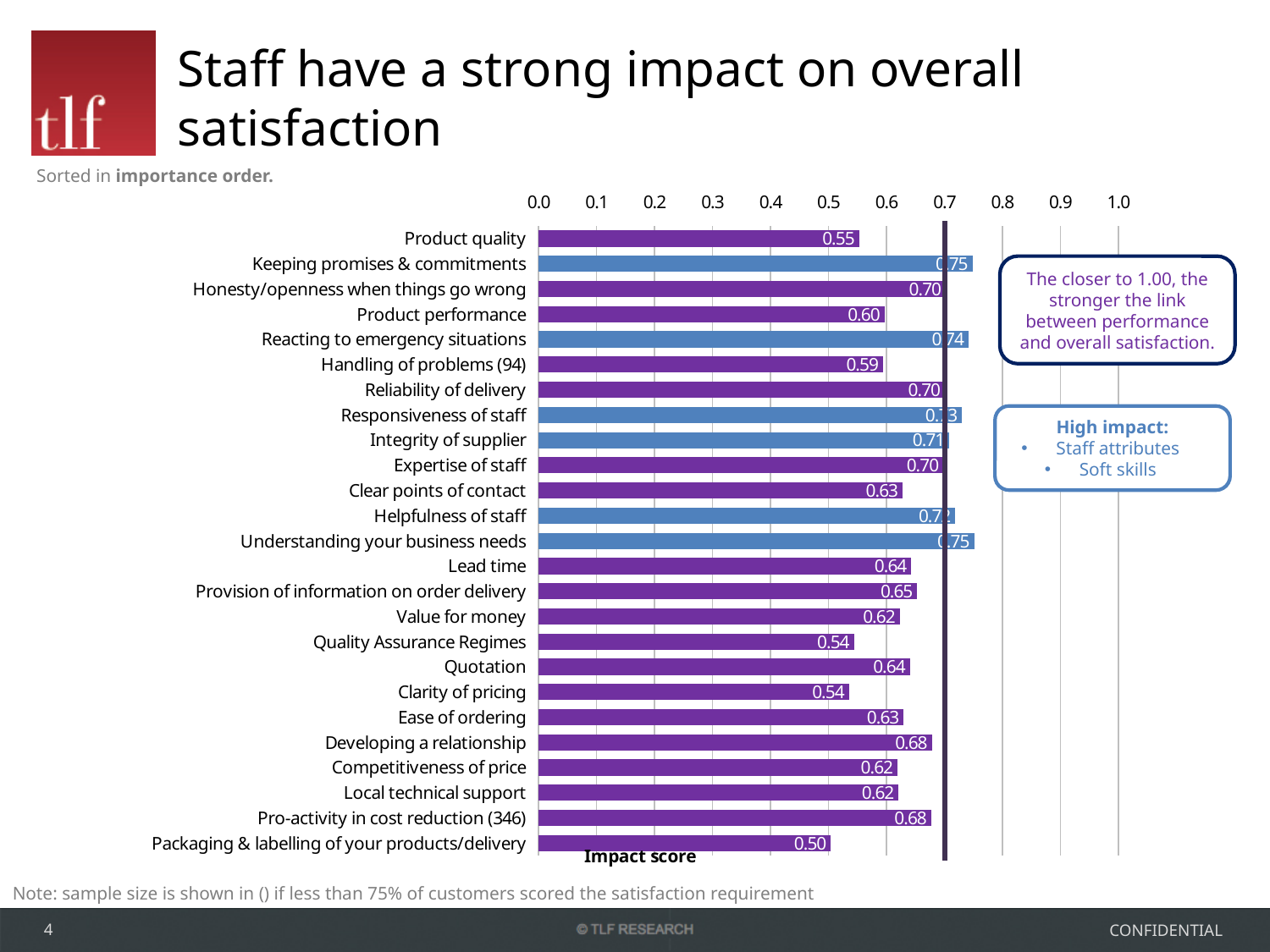
Is the impact score for Keeping promises & commitments greater or less than 0.7? greater What is the difference between the impact scores for Integrity of supplier and Product performance? 0.11 How many categories are shown in the chart? 25 What is the impact score for Developing a relationship? 0.68 What kind of chart is shown on the slide? Bar chart Which has a higher impact score, Lead time or Quality Assurance Regimes? Lead time Which category has the lowest impact score? Packaging & labelling of your products/delivery What is the impact score for Honesty/openness when things go wrong? 0.70 What is the title of the horizontal axis of the chart? Impact score What is the difference between the impact scores for Provision of information on order delivery and Clarity of pricing? 0.11 What is the impact score for Product quality? 0.55 What is the impact score for Packaging & labelling of your products/delivery? 0.50